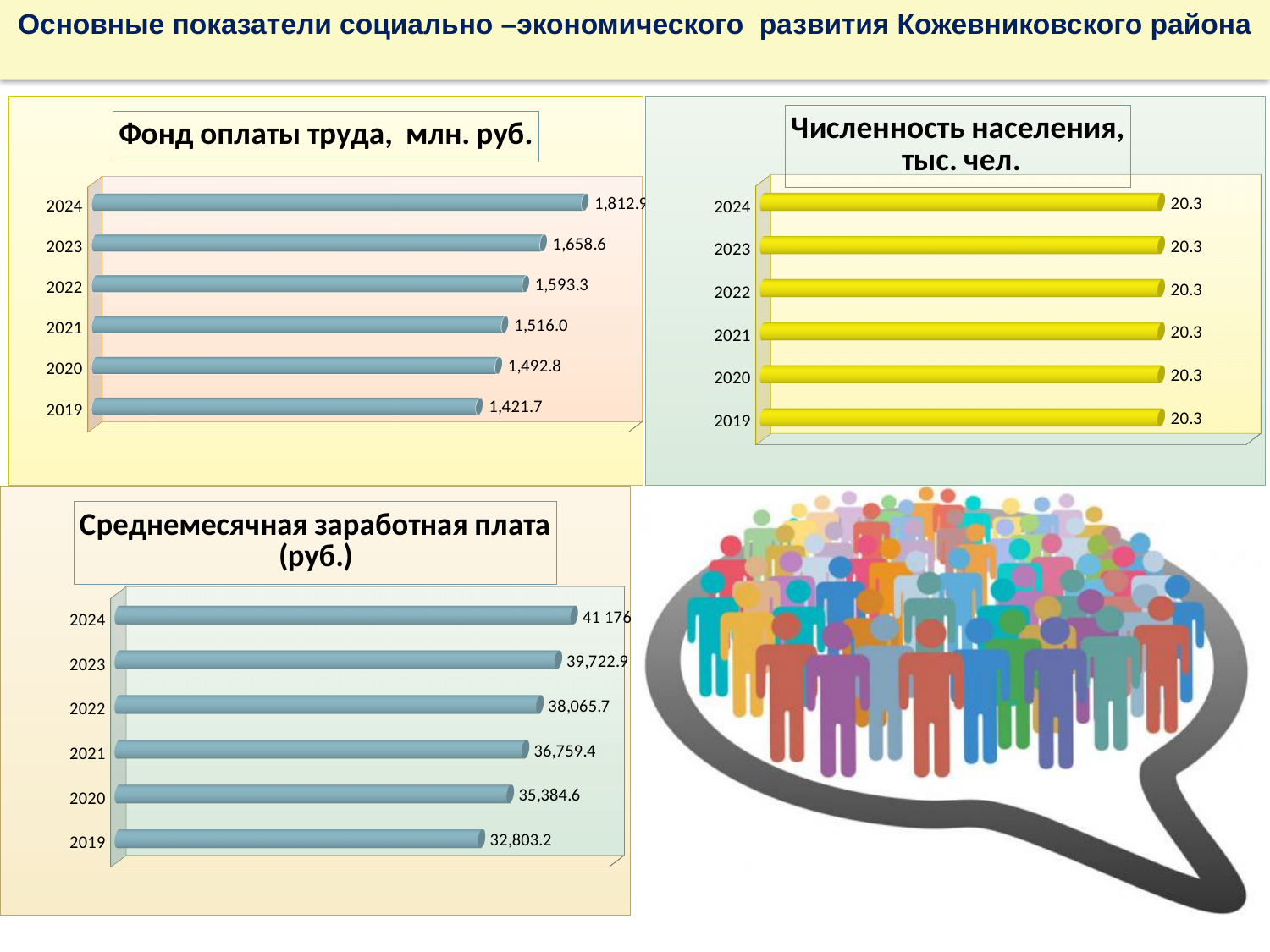
In the chart 'Фонд оплаты труда, млн. руб.', what is the value for 2023? 1,658.6 In the chart 'Фонд оплаты труда, млн. руб.', what is the value for 2019? 1,421.7 In the chart 'Численность населения, тыс. чел.', how many years are shown? 6 In the chart 'Фонд оплаты труда, млн. руб.', which year has the highest value? 2024 In the chart 'Среднемесячная заработная плата (руб.)', do the values rise or fall from 2019 to 2024? Rise In the chart 'Фонд оплаты труда, млн. руб.', what is the difference between the 2023 and 2022 values? 65.3 In the chart 'Среднемесячная заработная плата (руб.)', what is the value for 2022? 38,065.7 What type of chart is 'Фонд оплаты труда, млн. руб.'? Bar chart In the chart 'Численность населения, тыс. чел.', do the values change from 2019 to 2024? No, they stay at 20.3 In the chart 'Среднемесячная заработная плата (руб.)', which year has the lowest value? 2019 In the chart 'Среднемесячная заработная плата (руб.)', what is the difference between the 2020 and 2019 values? 2,581.4 In the chart 'Численность населения, тыс. чел.', what is the value for 2021? 20.3